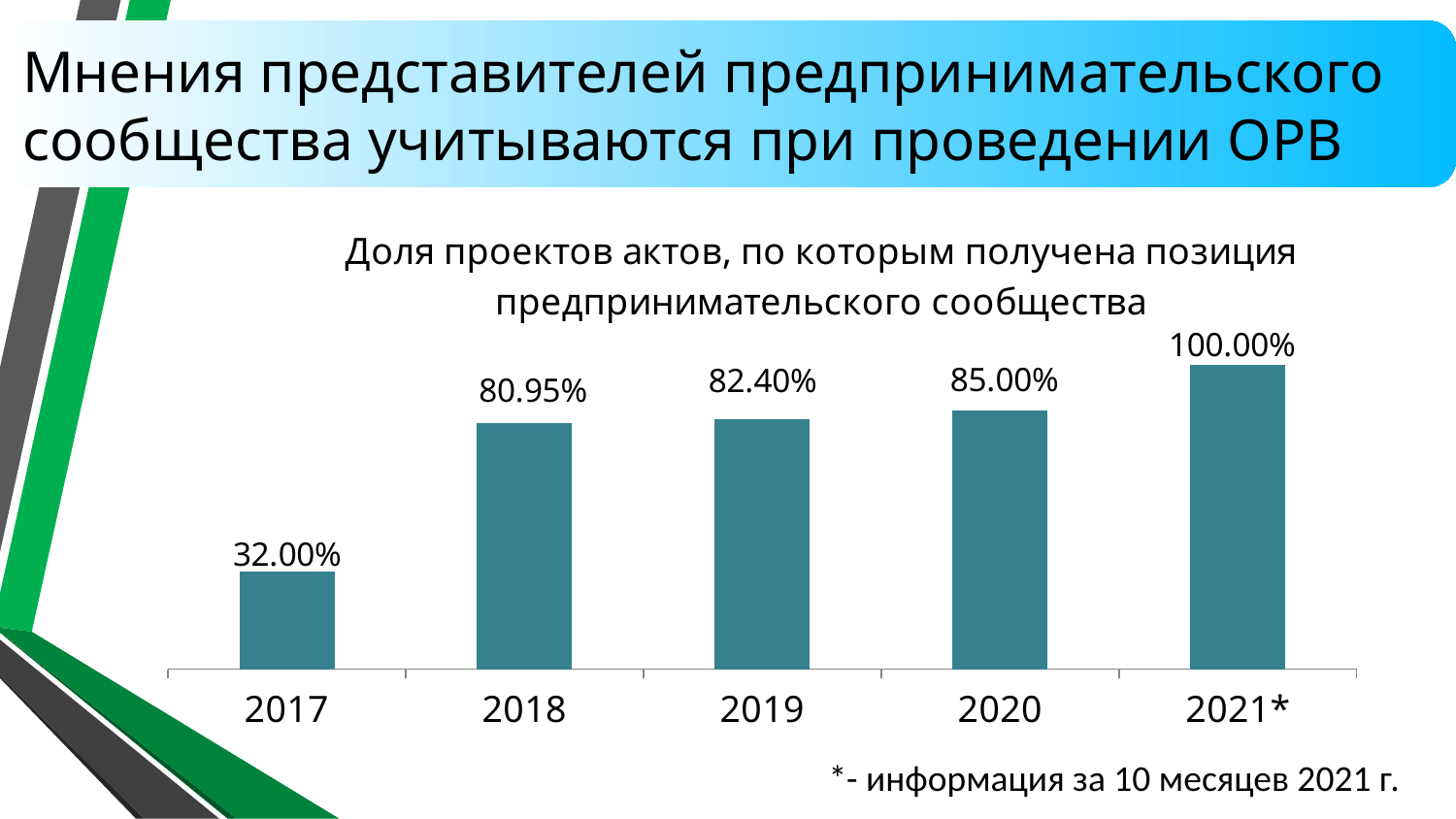
What is the difference between the values for 2020 and 2019? 2.60% What is the title of the chart? Доля проектов актов, по которым получена позиция предпринимательского сообщества What is the value for 2019? 82.40% What kind of chart is this? bar chart Which year has the lowest value? 2017 What is the value for 2017? 32.00% Do the values rise or fall from 2017 to 2021*? rise Which year has the highest value? 2021* Which is larger, the value for 2018 or the value for 2020? 2020 How many years are shown on the chart? 5 What is the difference between the values for 2018 and 2017? 48.95% What is the value for 2021*? 100.00%